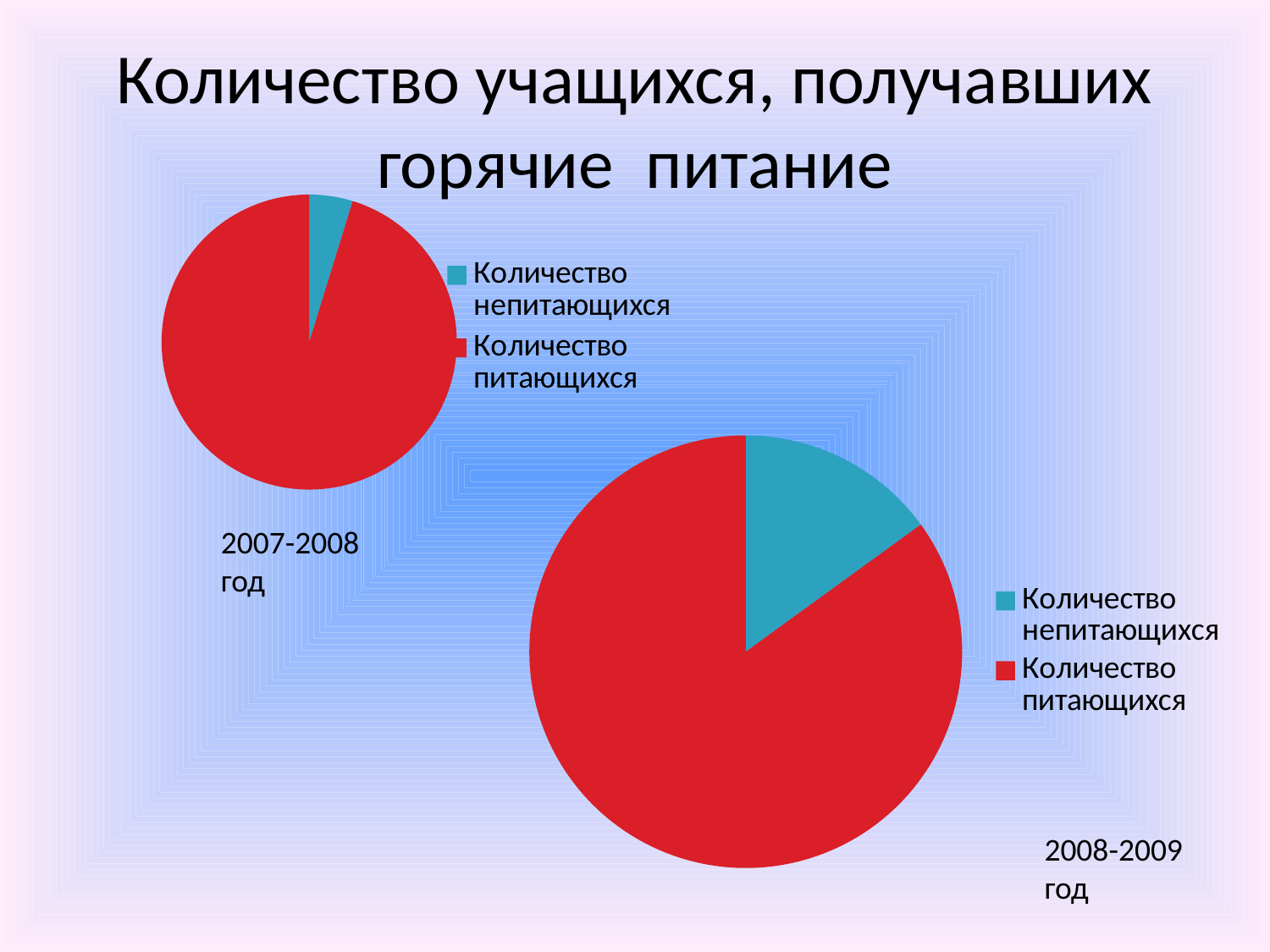
What kind of chart is the 2008-2009 год chart? pie chart How many slices does the 2007-2008 год pie chart have? 2 In the 2008-2009 год chart, which is larger: Количество непитающихся or Количество питающихся? Количество питающихся How many entries does the legend of the 2008-2009 год chart list? 2 In the 2007-2008 год chart, which category has the smallest slice? Количество непитающихся How many slices does the 2008-2009 год pie chart have? 2 How many entries does the legend of the 2007-2008 год chart list? 2 In the 2008-2009 год chart, which category has the largest slice? Количество питающихся What is the title of the slide containing the two pie charts? Количество учащихся, получавших горячие питание What kind of chart is the 2007-2008 год chart? pie chart In the 2007-2008 год chart, which category has the largest slice? Количество питающихся What colour represents Количество непитающихся in the 2008-2009 год chart? teal